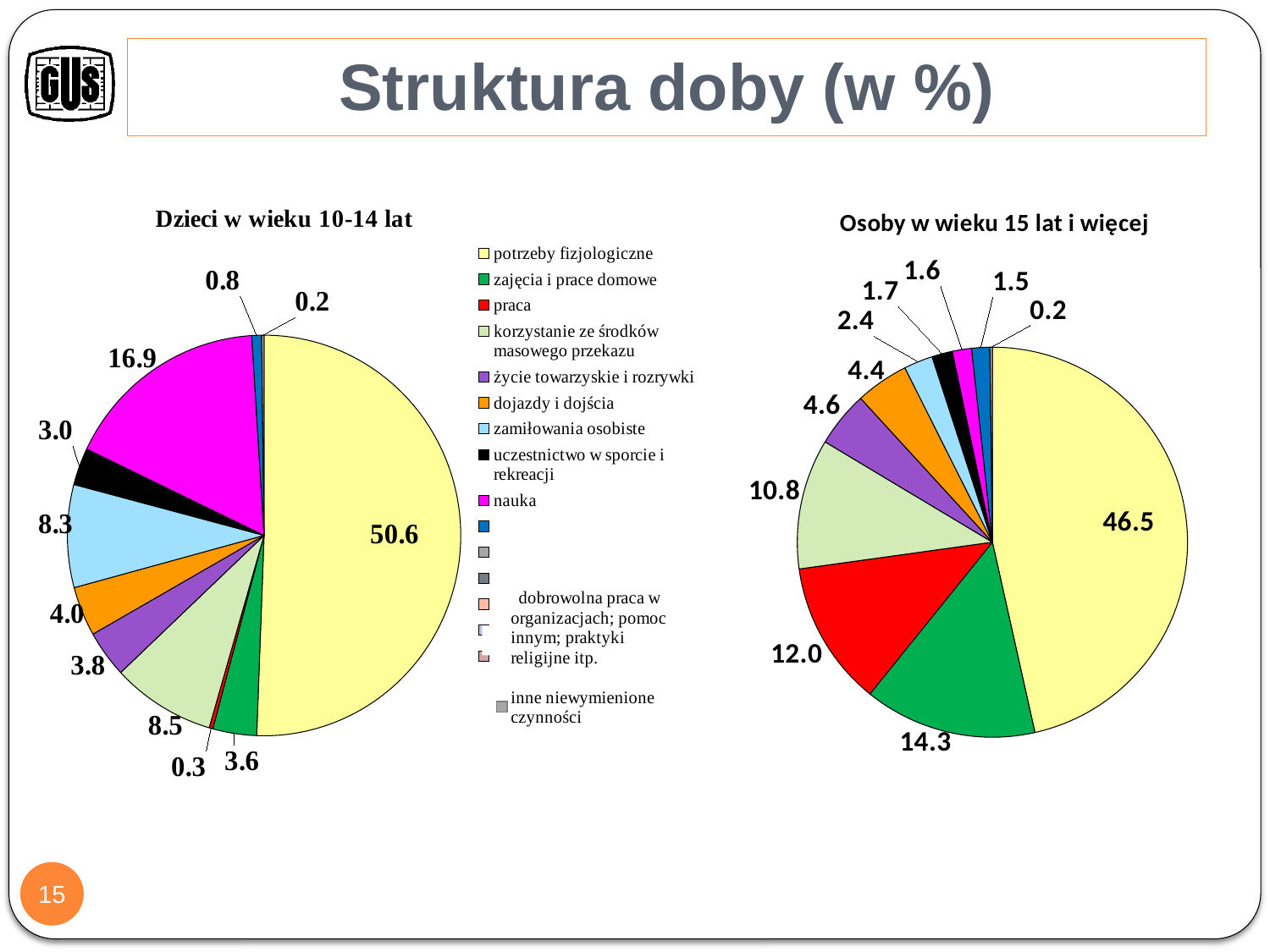
In the 'Dzieci w wieku 10-14 lat' chart, what is the difference between nauka and korzystanie ze środków masowego przekazu? 8.4 In the 'Osoby w wieku 15 lat i więcej' chart, which category has the largest slice? potrzeby fizjologiczne Which chart has the larger value for praca: 'Dzieci w wieku 10-14 lat' or 'Osoby w wieku 15 lat i więcej'? Osoby w wieku 15 lat i więcej What kind of chart is used on this slide? pie chart In the 'Dzieci w wieku 10-14 lat' chart, which category has the largest slice? potrzeby fizjologiczne In the 'Dzieci w wieku 10-14 lat' chart, what is the value for potrzeby fizjologiczne? 50.6 In the 'Osoby w wieku 15 lat i więcej' chart, what is the value for praca? 12.0 In the 'Dzieci w wieku 10-14 lat' chart, what is the value for nauka? 16.9 In the 'Osoby w wieku 15 lat i więcej' chart, which is larger: życie towarzyskie i rozrywki or korzystanie ze środków masowego przekazu? korzystanie ze środków masowego przekazu In the 'Osoby w wieku 15 lat i więcej' chart, what is the value for zajęcia i prace domowe? 14.3 How many slices does the 'Osoby w wieku 15 lat i więcej' pie chart have? 11 What is the difference between the potrzeby fizjologiczne values in the 'Dzieci w wieku 10-14 lat' chart and the 'Osoby w wieku 15 lat i więcej' chart? 4.1